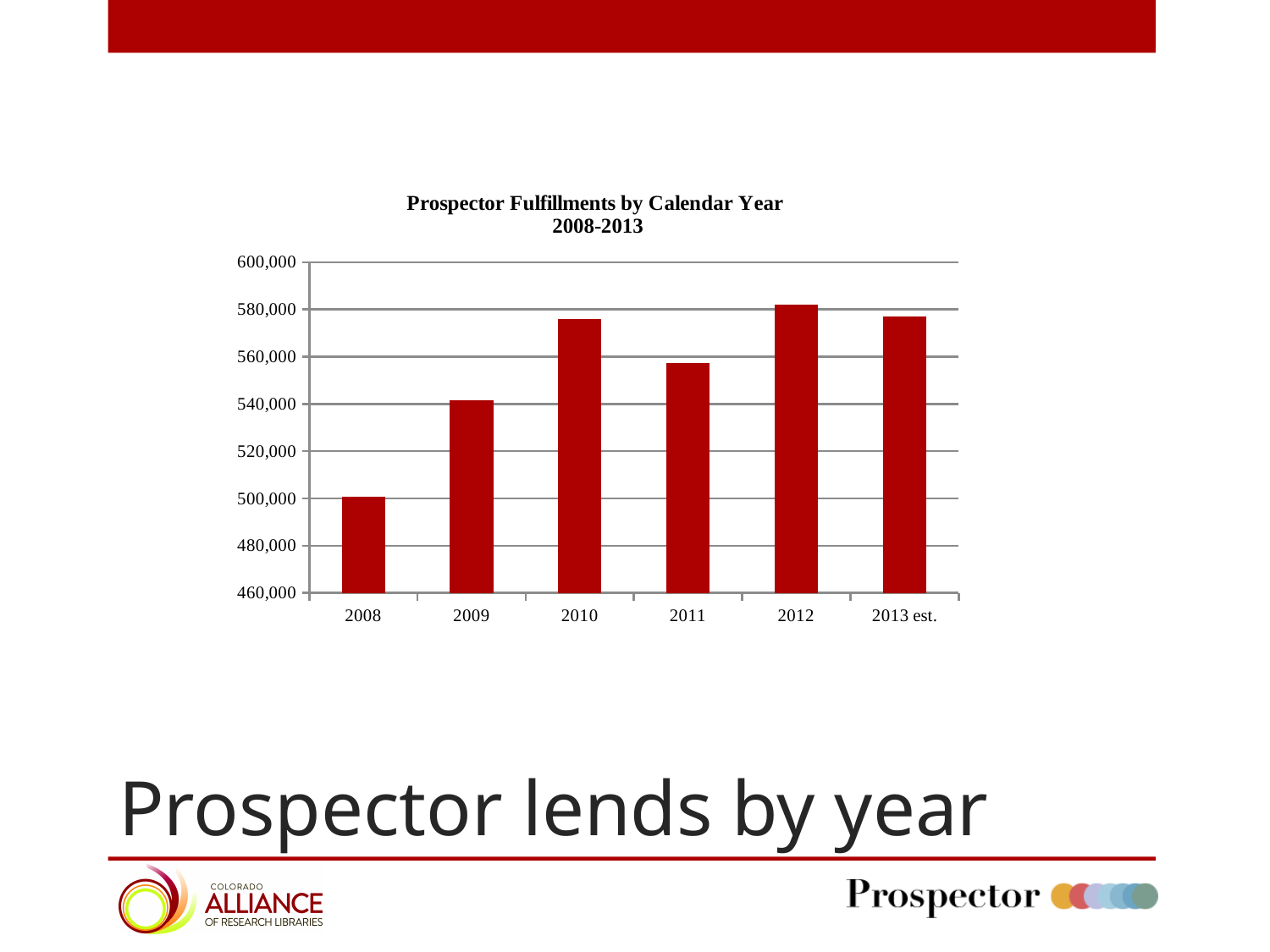
Do the values rise or fall from 2008 to 2010? rise Which year has the highest number of fulfillments? 2012 What is the title of the chart? Prospector Fulfillments by Calendar Year 2008-2013 Which year has more fulfillments, 2009 or 2011? 2011 Is the value for 2008 greater or less than 520,000? less Is the value for 2009 greater or less than 520,000? greater Which year has the lowest number of fulfillments? 2008 Is the value for 2012 greater or less than 560,000? greater What kind of chart is shown on the slide? bar chart Which year has more fulfillments, 2010 or 2011? 2010 How many years (categories) are plotted on the x axis? 6